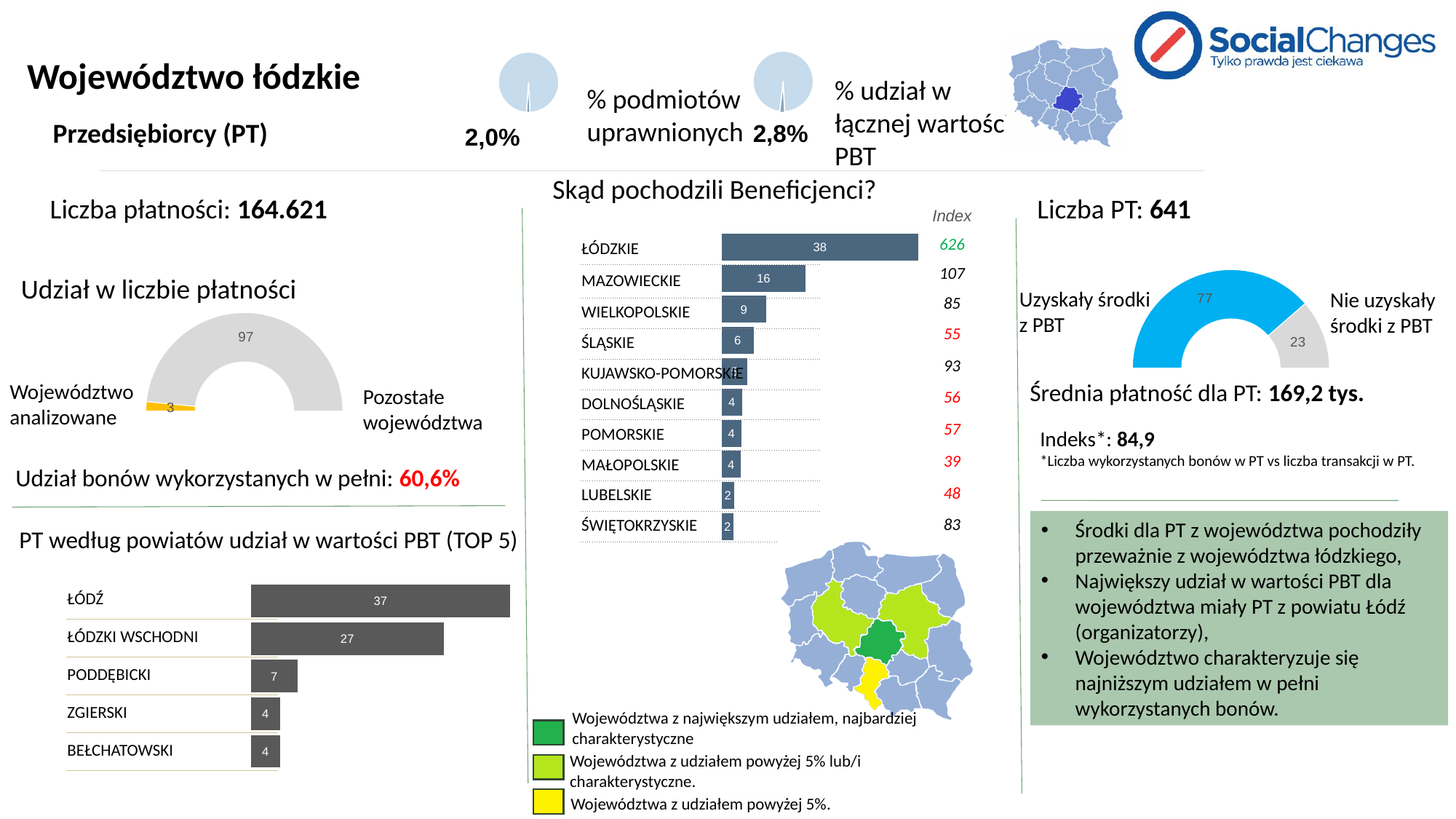
In the 'Udział w liczbie płatności' chart, what is the value for Pozostałe województwa? 97 In the 'PT według powiatów udział w wartości PBT (TOP 5)' chart, which powiat has the highest value? ŁÓDŹ In the 'Skąd pochodzili Beneficjenci?' chart, what is the value for ŁÓDZKIE? 38 How many regions are listed in the 'Skąd pochodzili Beneficjenci?' chart? 10 In the 'Skąd pochodzili Beneficjenci?' chart, what is the difference between the values for ŁÓDZKIE and MAZOWIECKIE? 22 In the 'PT według powiatów udział w wartości PBT (TOP 5)' chart, which is larger: PODDĘBICKI or ZGIERSKI? PODDĘBICKI In the 'Skąd pochodzili Beneficjenci?' chart, what is the Index value shown for ŁÓDZKIE? 626 In the semi-donut chart next to 'Liczba PT: 641', what is the value for 'Nie uzyskały środki z PBT'? 23 In the 'Skąd pochodzili Beneficjenci?' chart, which region has the highest value? ŁÓDZKIE In the 'Skąd pochodzili Beneficjenci?' chart, what is the value for MAZOWIECKIE? 16 In the 'PT według powiatów udział w wartości PBT (TOP 5)' chart, what is the value for ŁÓDZKI WSCHODNI? 27 What kind of chart is 'PT według powiatów udział w wartości PBT (TOP 5)'? Bar chart